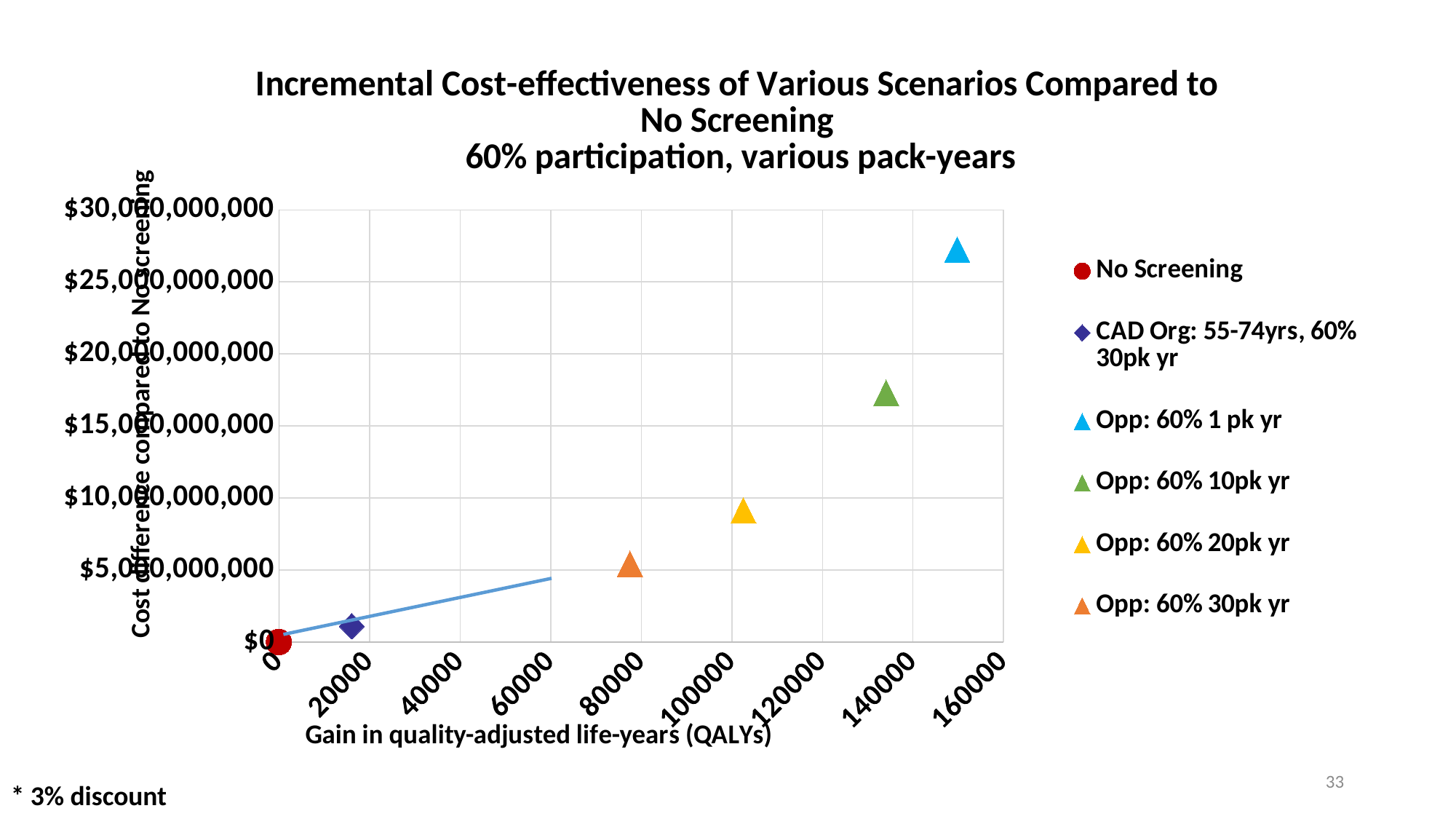
Which series has the lowest cost difference compared to No Screening? No Screening Is the cost difference for Opp: 60% 20pk yr greater or less than $10,000,000,000? less What is the label of the x axis? Gain in quality-adjusted life-years (QALYs) Is the cost difference for Opp: 60% 1 pk yr greater or less than $25,000,000,000? greater Which series has the larger gain in QALYs, Opp: 60% 30pk yr or Opp: 60% 1 pk yr? Opp: 60% 1 pk yr Is the gain in QALYs for Opp: 60% 1 pk yr greater or less than 140000? greater Which series has the larger cost difference, Opp: 60% 10pk yr or Opp: 60% 20pk yr? Opp: 60% 10pk yr Which series has the highest cost difference compared to No Screening? Opp: 60% 1 pk yr How many series does the legend list? 6 What kind of chart is shown on the slide? scatter chart